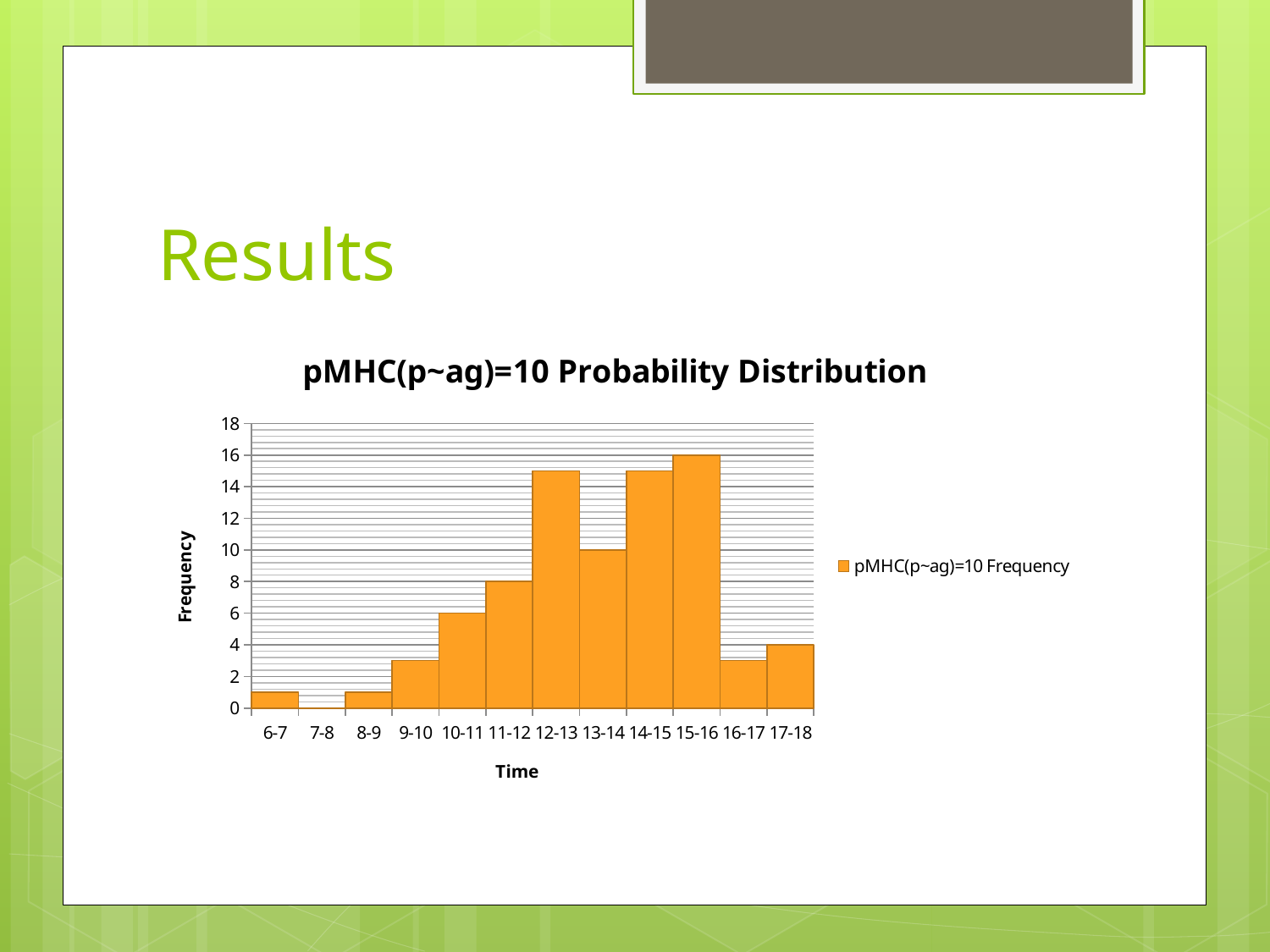
How many time bins are shown on the x axis? 12 What is the frequency for the 15-16 time bin? 16 What is the difference in frequency between the 15-16 bin and the 13-14 bin? 6 Is the frequency for the 12-13 bin greater or less than 14? greater What is the frequency for the 17-18 time bin? 4 Which time bin has the lowest frequency? 7-8 What is the title of the chart? pMHC(p~ag)=10 Probability Distribution Which time bin has the highest frequency? 15-16 Which has a higher frequency, the 10-11 bin or the 11-12 bin? 11-12 What is the frequency for the 11-12 time bin? 8 What type of chart is shown on the slide? bar chart What is the frequency for the 13-14 time bin? 10